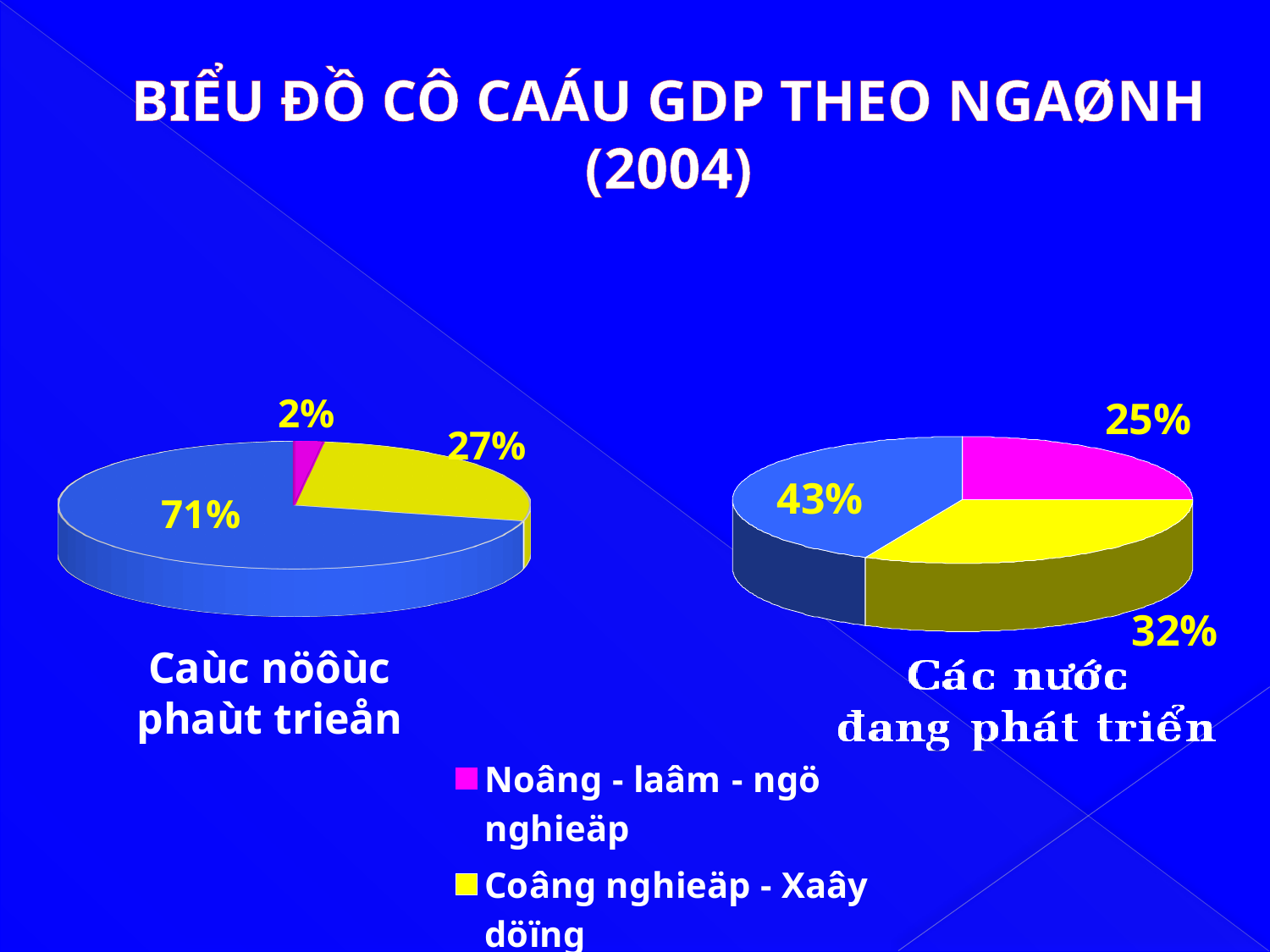
How many slices does each pie chart have? 3 In the left pie chart (developed countries), what is the share of the yellow slice (Coâng nghieäp - Xaây döïng)? 27% In the left pie chart (developed countries), which slice is the largest? The blue slice (71%) In the right pie chart (developing countries), what is the share of the magenta slice (Noâng - laâm - ngö nghieäp)? 25% In the right pie chart (developing countries), what is the share of the yellow slice (Coâng nghieäp - Xaây döïng)? 32% What is the difference between the yellow slice in the right pie chart (32%) and the yellow slice in the left pie chart (27%)? 5 percentage points In the left pie chart (developed countries), what is the share of the magenta slice (Noâng - laâm - ngö nghieäp)? 2% In the right pie chart (developing countries), what is the share of the blue slice? 43% In the right pie chart (developing countries), which slice is the smallest? Noâng - laâm - ngö nghieäp (25%) Which is larger: the magenta slice in the left pie chart or the magenta slice in the right pie chart? The right pie chart (25%) What kind of charts are shown on the slide? Pie charts In the left pie chart (developed countries), what is the share of the blue slice? 71%